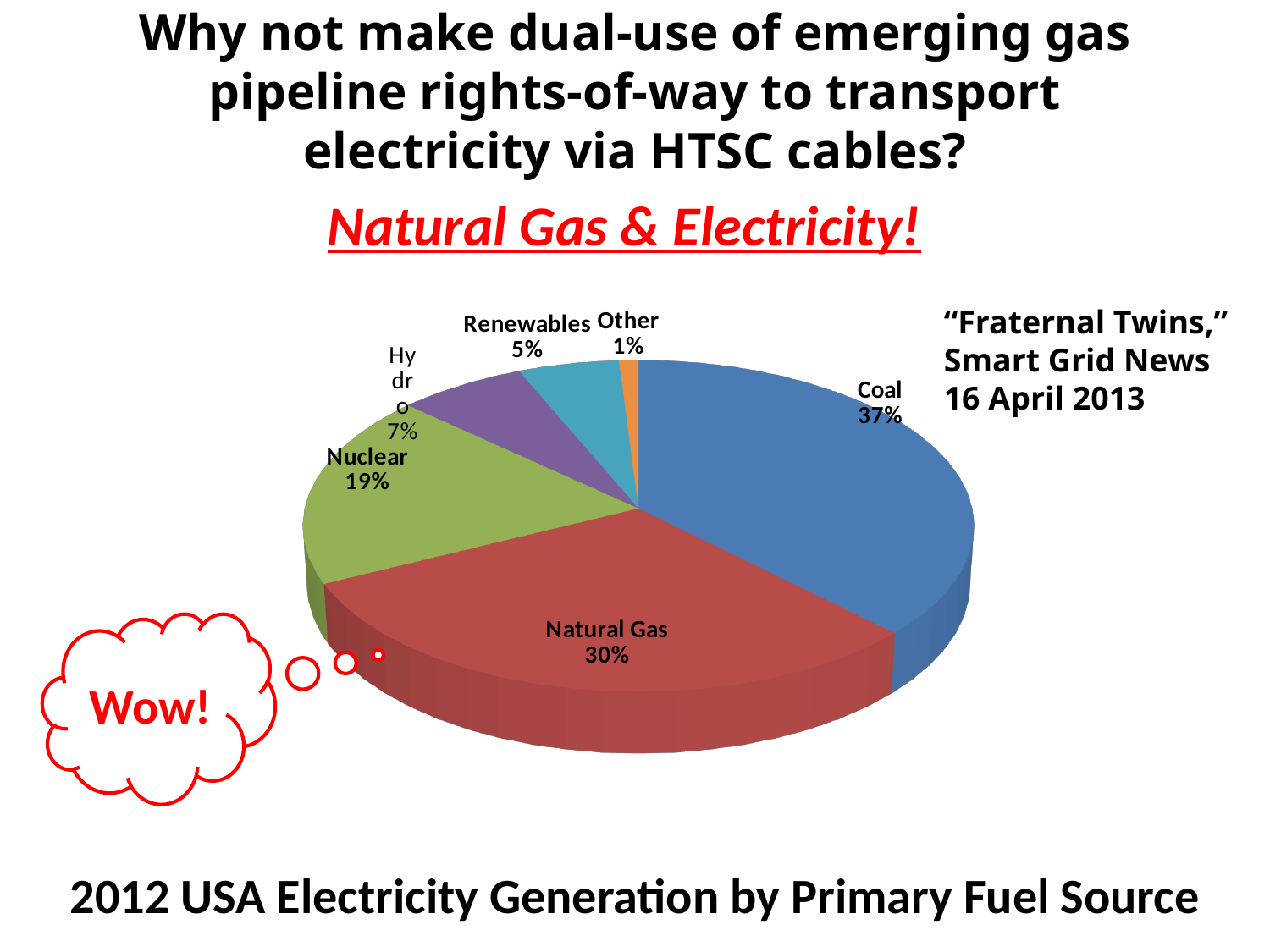
What share of 2012 USA electricity generation came from Coal? 37% Which fuel source has the largest share of the pie? Coal How many percentage points larger is Coal's share than Natural Gas's share? 7 What share of 2012 USA electricity generation came from Renewables? 5% What share of 2012 USA electricity generation came from Nuclear? 19% What share of 2012 USA electricity generation came from Hydro? 7% What is the title of the chart at the bottom of the slide? 2012 USA Electricity Generation by Primary Fuel Source What share of 2012 USA electricity generation came from Natural Gas? 30% Which fuel source has the smallest share of the pie? Other How many fuel source categories are shown in the pie chart? 6 Which has a larger share, Nuclear or Hydro? Nuclear What kind of chart is shown on the slide? Pie chart